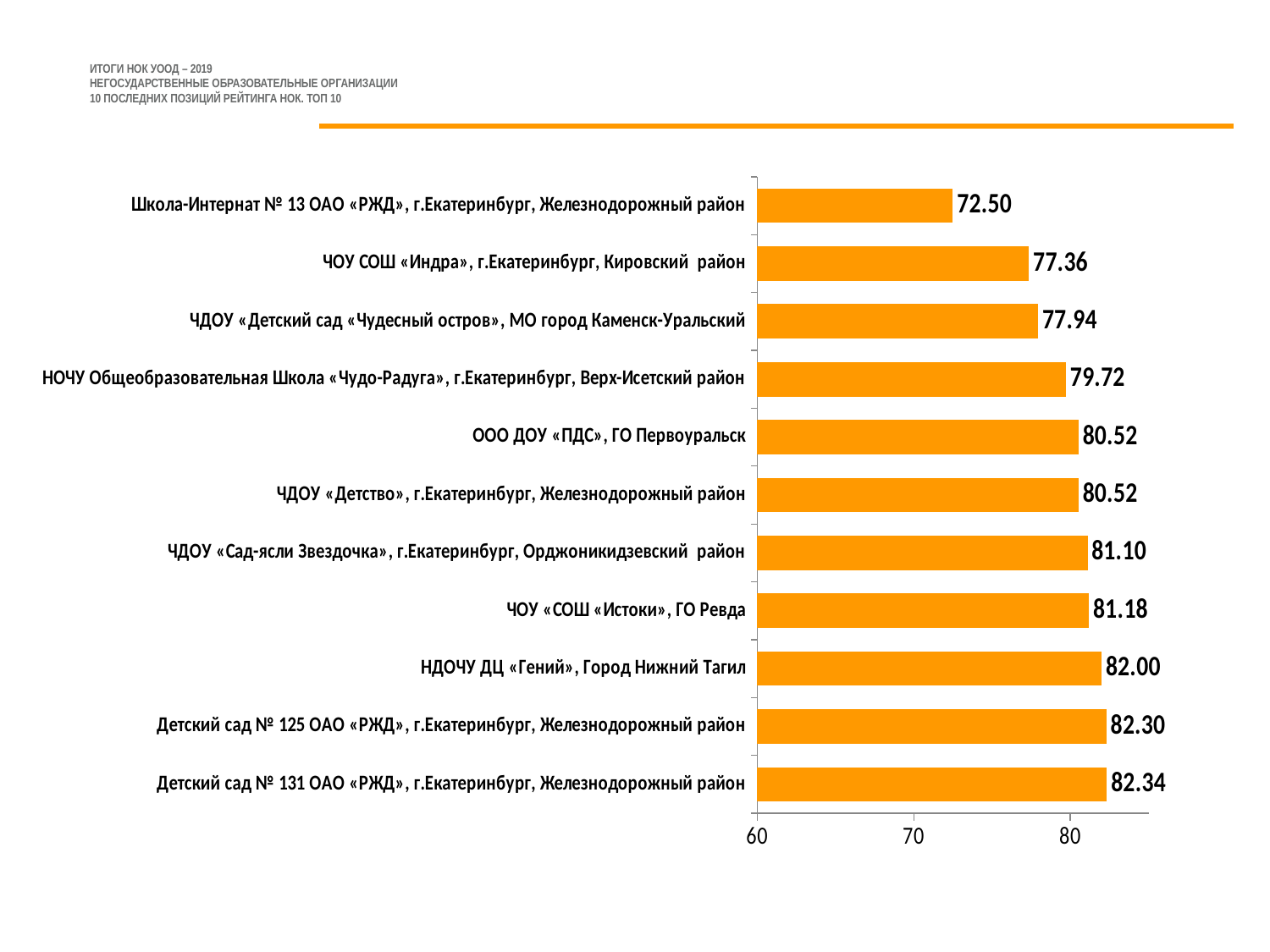
What colour are the bars on the chart? orange Which has a larger value: ЧДОУ «Детский сад «Чудесный остров», МО город Каменск-Уральский or ООО ДОУ «ПДС», ГО Первоуральск? ООО ДОУ «ПДС», ГО Первоуральск What is the difference between the values for ЧОУ «СОШ «Истоки», ГО Ревда and ЧДОУ «Сад-ясли Звездочка»? 0.08 What is the value for ЧОУ СОШ «Индра», г.Екатеринбург, Кировский район? 77.36 How many organisations are shown on the chart? 11 Which organisation has the lowest value on the chart? Школа-Интернат № 13 ОАО «РЖД», г.Екатеринбург, Железнодорожный район What kind of chart is shown on the slide? bar chart What is the difference between the values for Детский сад № 131 ОАО «РЖД» and Школа-Интернат № 13 ОАО «РЖД»? 9.84 What is the value for НДОЧУ ДЦ «Гений», Город Нижний Тагил? 82.00 Which organisation has the highest value on the chart? Детский сад № 131 ОАО «РЖД», г.Екатеринбург, Железнодорожный район What is the value for НОЧУ Общеобразовательная Школа «Чудо-Радуга», г.Екатеринбург, Верх-Исетский район? 79.72 Is the value for Школа-Интернат № 13 ОАО «РЖД» greater or less than 80? less